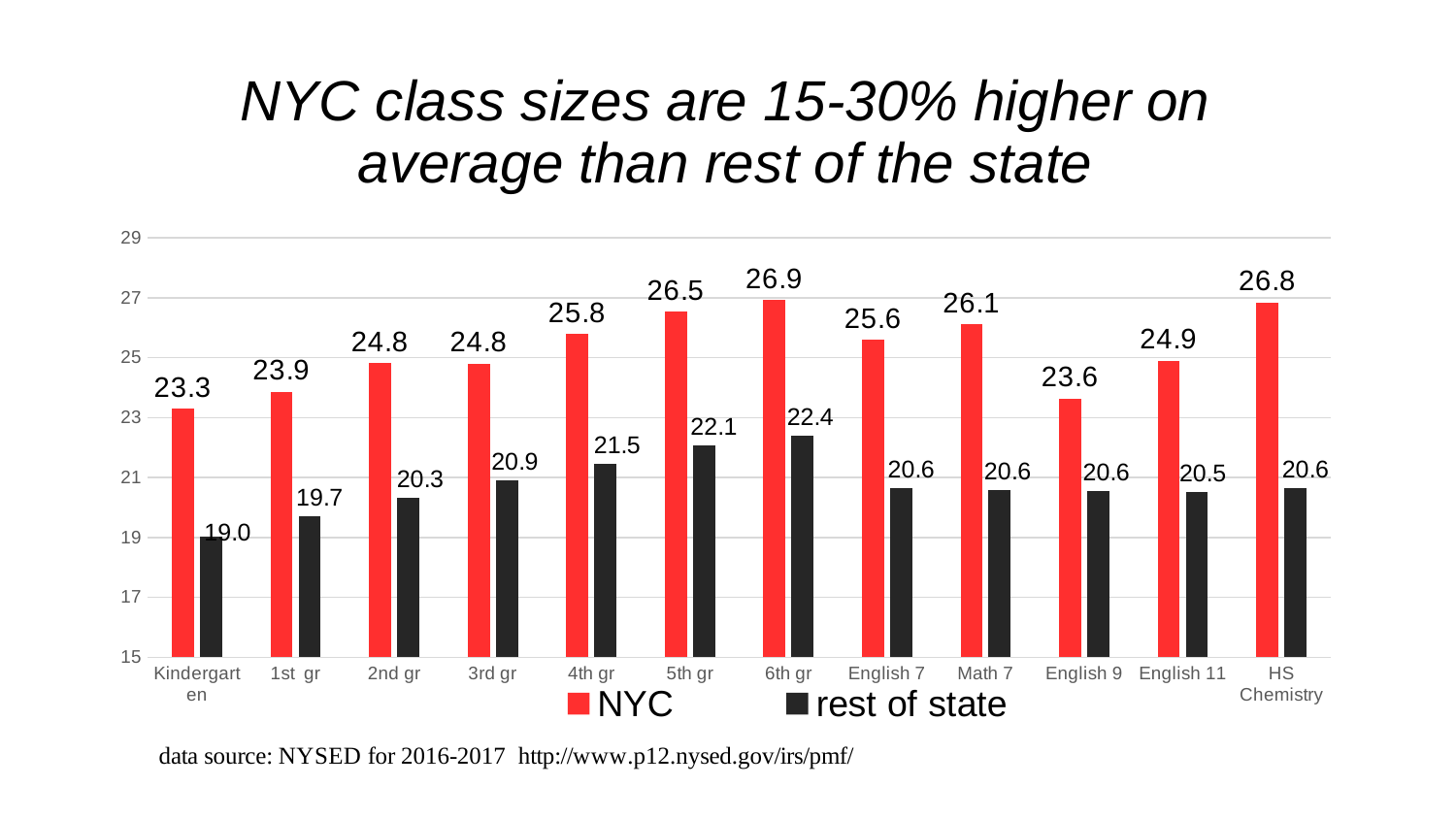
Which colour represents the NYC series? red What is the rest of state value for 5th gr? 22.1 How many categories are shown on the x axis? 12 What is the rest of state class size for Kindergarten? 19.0 How many series does the legend list? 2 Which is larger, the NYC value for 4th gr or the NYC value for English 9? 4th gr Which category has the lowest rest of state class size? Kindergarten Which category has the highest NYC class size? 6th gr What kind of chart is shown on the slide? bar chart What is the difference between the NYC and rest of state values for HS Chemistry? 6.2 What is the NYC class size for 6th gr? 26.9 Is the NYC value for 3rd gr greater or less than 23? greater